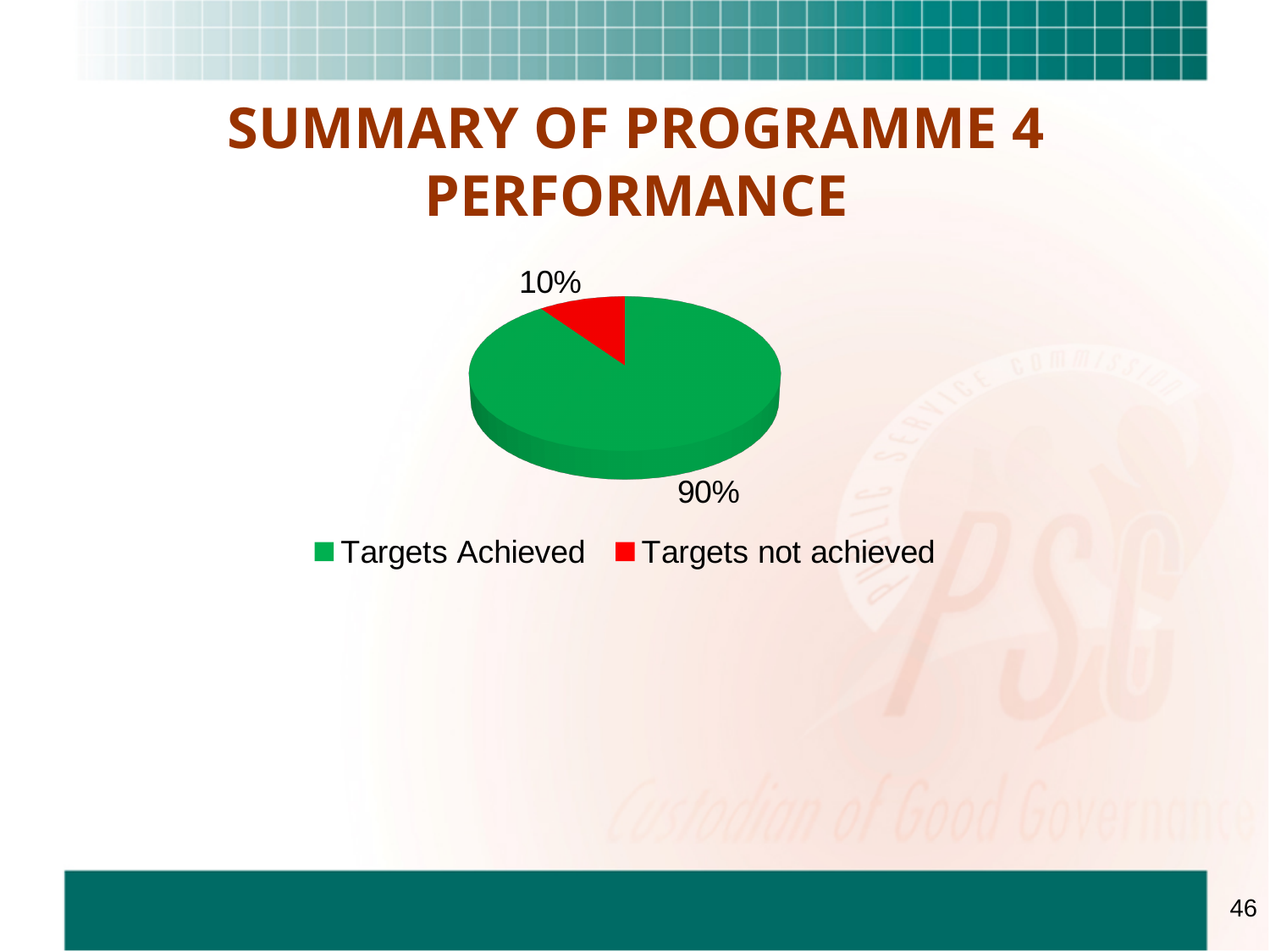
How many entries does the legend list? 2 What is the title of the slide containing the pie chart? SUMMARY OF PROGRAMME 4 PERFORMANCE Which is larger, the share for Targets Achieved or the share for Targets not achieved? Targets Achieved How many slices does the pie chart have? 2 What share of the pie does the Targets Achieved slice represent? 90% What percentage of the pie is labelled Targets not achieved? 10% Which category has the largest share of the pie? Targets Achieved What colour is the Targets not achieved slice? Red What kind of chart is shown on the slide? Pie chart What percentage of the pie is labelled Targets Achieved? 90% Which category has the smallest share of the pie? Targets not achieved What is the difference in percentage points between Targets Achieved and Targets not achieved? 80